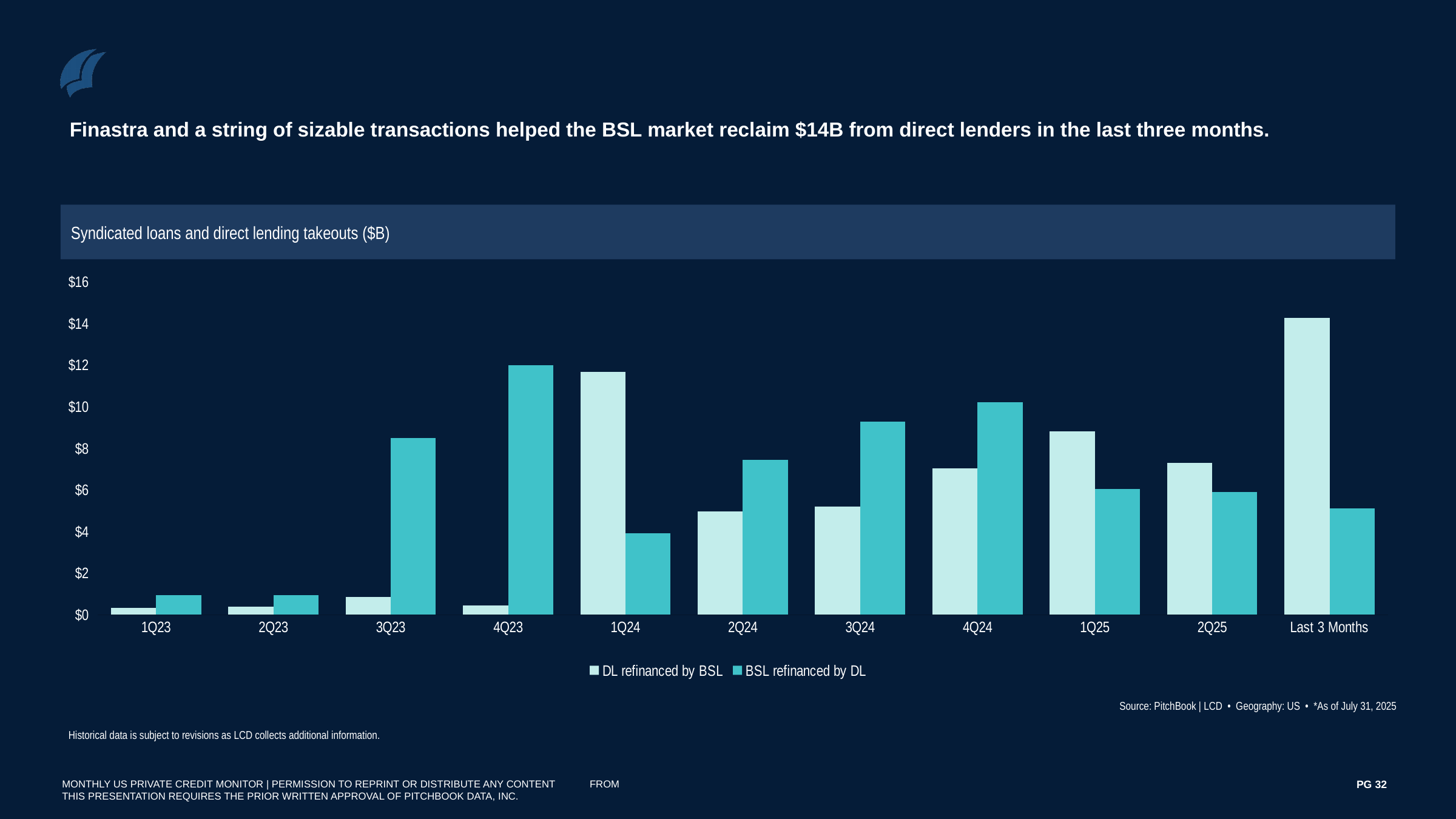
Which category has the highest value for BSL refinanced by DL? 4Q23 What kind of chart is shown on the slide? Bar chart Is the value for DL refinanced by BSL in Last 3 Months greater or less than $12? greater In 3Q24, which series has the larger value: DL refinanced by BSL or BSL refinanced by DL? BSL refinanced by DL How many categories are shown on the x axis? 11 Is the value for BSL refinanced by DL in 1Q24 greater or less than $6? less Is the value for BSL refinanced by DL in 3Q24 greater or less than $8? greater How many series does the legend list? 2 In 1Q24, which series has the larger value: DL refinanced by BSL or BSL refinanced by DL? DL refinanced by BSL Which category has the highest value for DL refinanced by BSL? Last 3 Months What is the title of the chart? Syndicated loans and direct lending takeouts ($B)